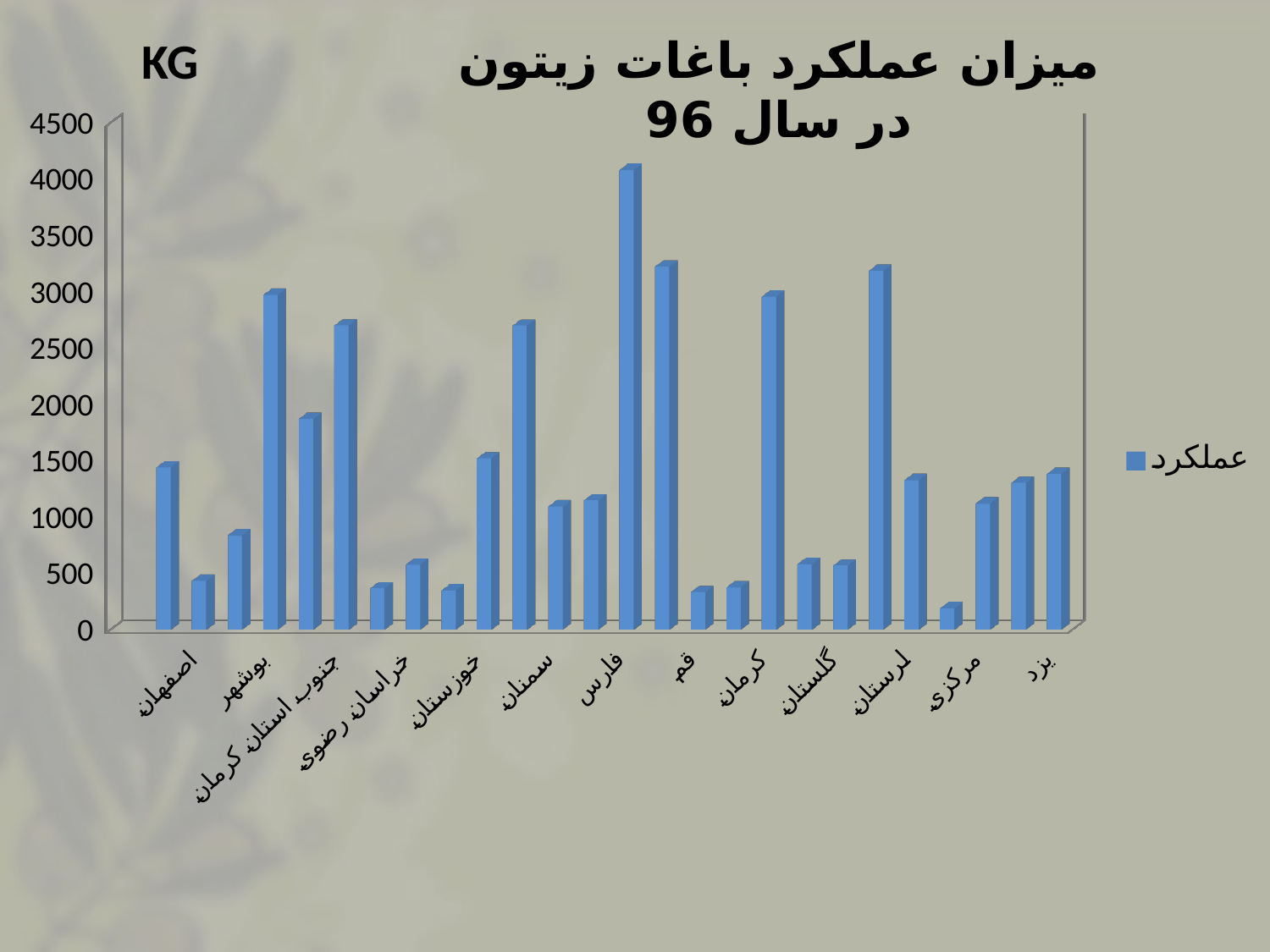
What is the highest tick value shown on the vertical axis? 4500 What is the legend entry for the series in the chart? عملکرد Is the tallest bar in the chart greater or less than 4000? greater How many series does the legend list? 1 What kind of chart is shown on the slide? bar chart What unit is shown at the top of the vertical axis? KG How many category labels are printed along the x axis? 13 Is the shortest bar in the chart greater or less than 500? less